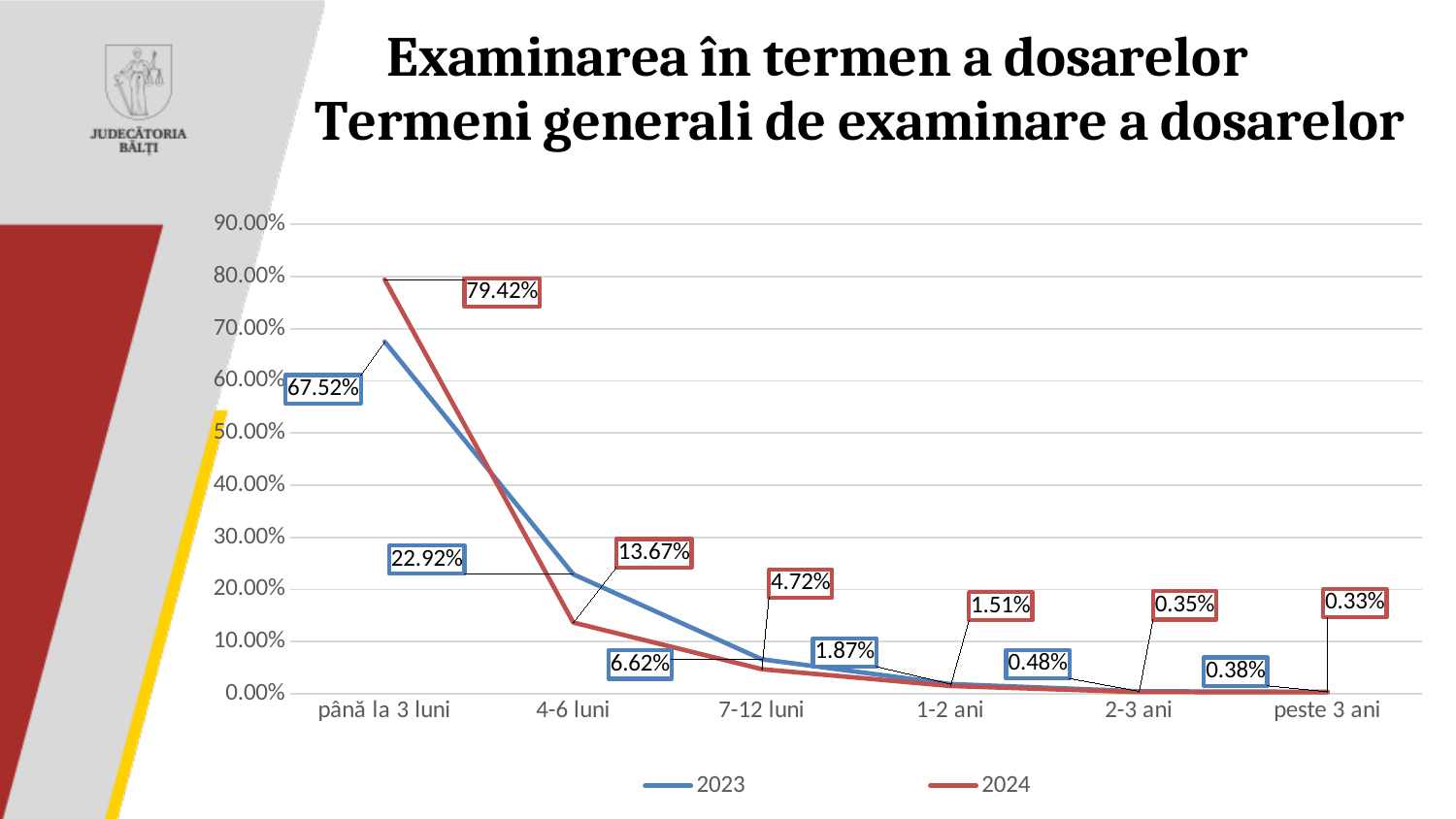
How many series does the legend list? 2 Which category has the highest value for the 2023 series? până la 3 luni What is the value for 2024 at '7-12 luni'? 4.72% Which category has the lowest value for the 2024 series? peste 3 ani What is the difference between the 2024 and 2023 values at 'până la 3 luni'? 11.90% What is the value for 2024 at 'până la 3 luni'? 79.42% Do the values for the 2024 series rise or fall from left to right along the x axis? fall What is the value for 2023 at 'peste 3 ani'? 0.38% How many categories are shown on the x axis? 6 At '4-6 luni', which series has the larger value, 2023 or 2024? 2023 What is the value for 2023 at '4-6 luni'? 22.92% What kind of chart is shown on the slide? line chart